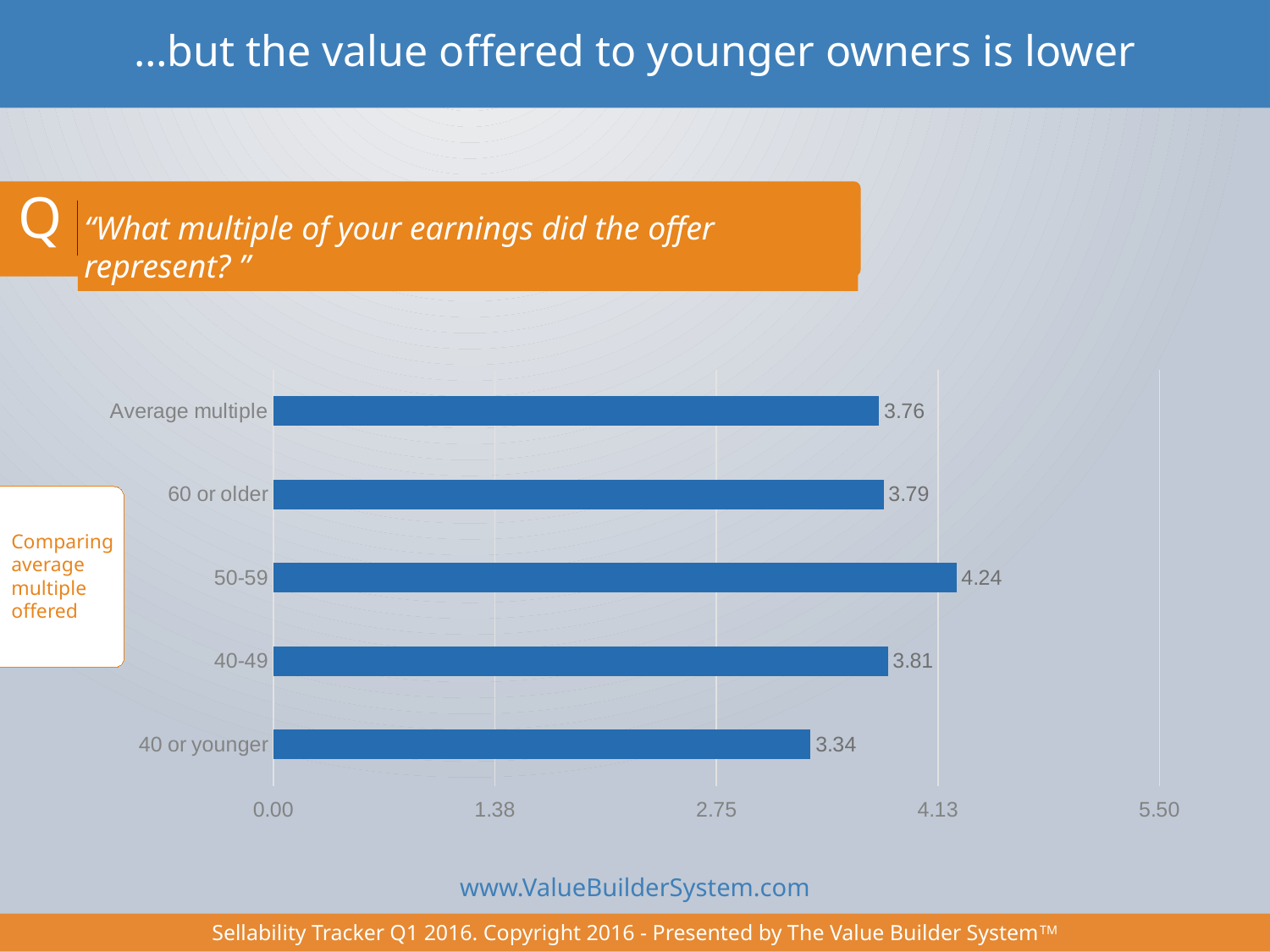
What is the value for the Average multiple category? 3.76 What is the difference between the values for 40-49 and 60 or older? 0.02 Which category has the highest value? 50-59 Which is larger, the value for 50-59 or the value for 60 or older? 50-59 Which category has the lowest value? 40 or younger What is the difference between the values for 50-59 and 40 or younger? 0.90 What is the highest value shown on the x axis? 5.50 How many categories are shown in the chart? 5 What is the value for the 50-59 category? 4.24 Is the value for 40 or younger greater or less than 4.13? less What is the value for the 40 or younger category? 3.34 What kind of chart is shown on the slide? bar chart